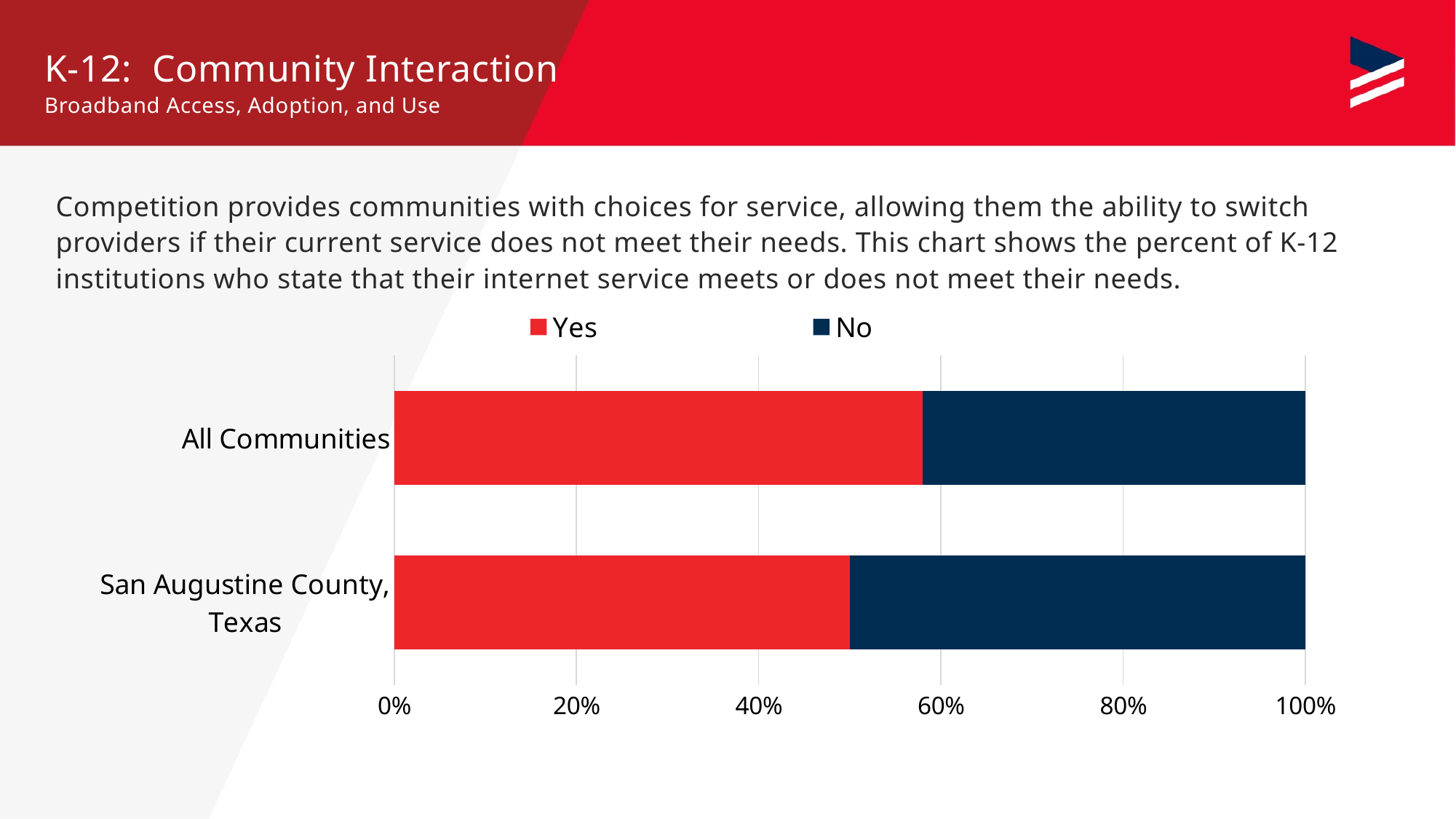
Is the "Yes" value for All Communities greater or less than 40%? greater Is the "No" value for San Augustine County, Texas greater or less than 60%? less What kind of chart is shown on the slide? bar chart Is the "Yes" value for San Augustine County, Texas greater or less than 60%? less How many categories are plotted on the chart? 2 How many series does the chart's legend list? 2 Which category has the larger "No" share: All Communities or San Augustine County, Texas? San Augustine County, Texas Which category has the highest "Yes" value? All Communities Which category has the larger "Yes" share: All Communities or San Augustine County, Texas? All Communities Which colour represents the "Yes" series? red What are the two series named in the legend? Yes and No